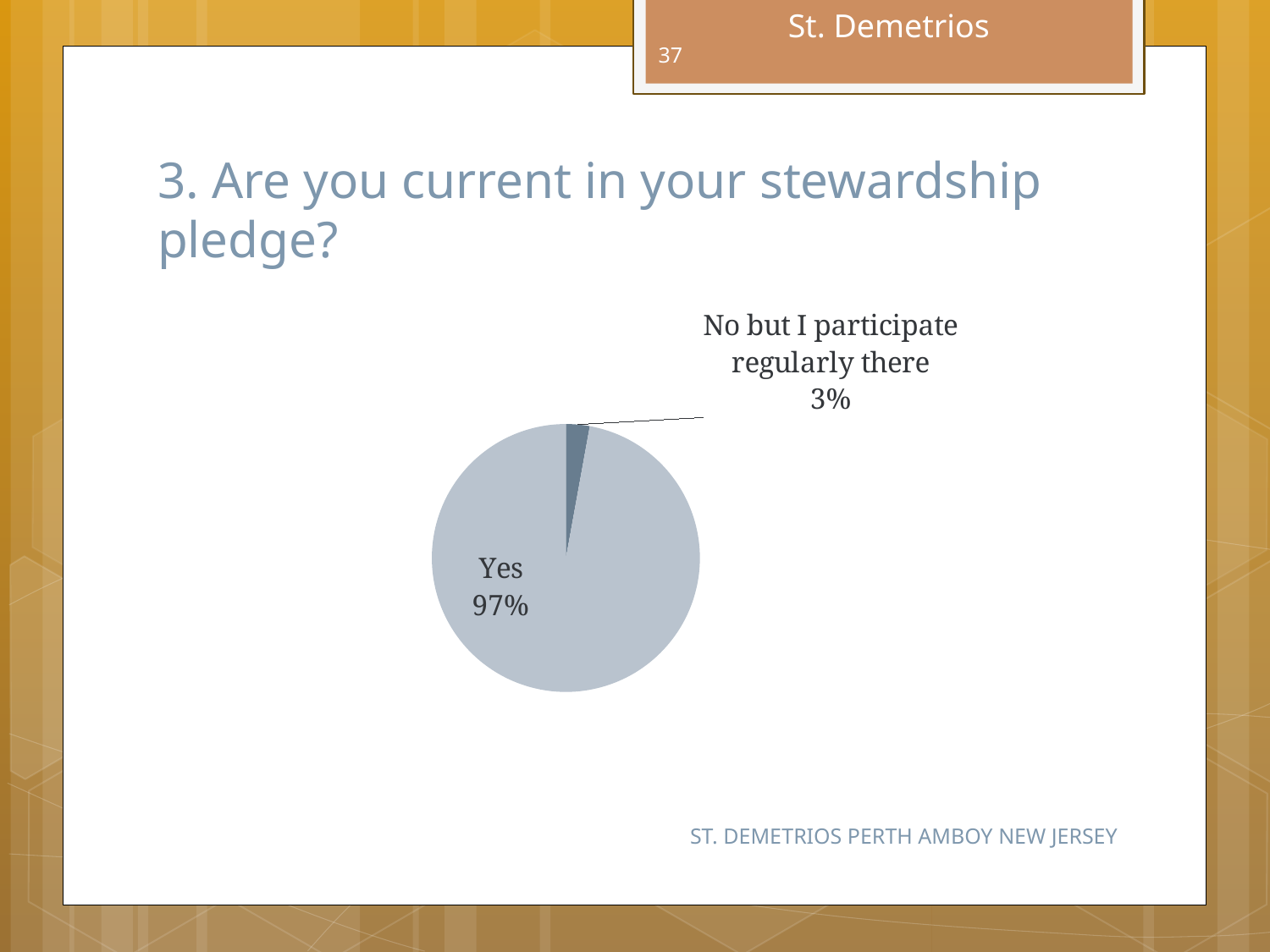
How many slices does the pie chart have? 2 What is the total of the two percentages shown on the pie chart? 100% What share of the pie is labelled "No but I participate regularly there"? 3% Which slice of the pie is the smallest? No but I participate regularly there What kind of chart is shown on the slide? pie chart What is the difference in percentage points between the "Yes" slice and the "No but I participate regularly there" slice? 94 Which is larger, the "Yes" slice or the "No but I participate regularly there" slice? Yes Which slice of the pie is the largest? Yes What share of the pie is labelled "Yes"? 97% What survey question does the pie chart on the slide answer? 3. Are you current in your stewardship pledge?